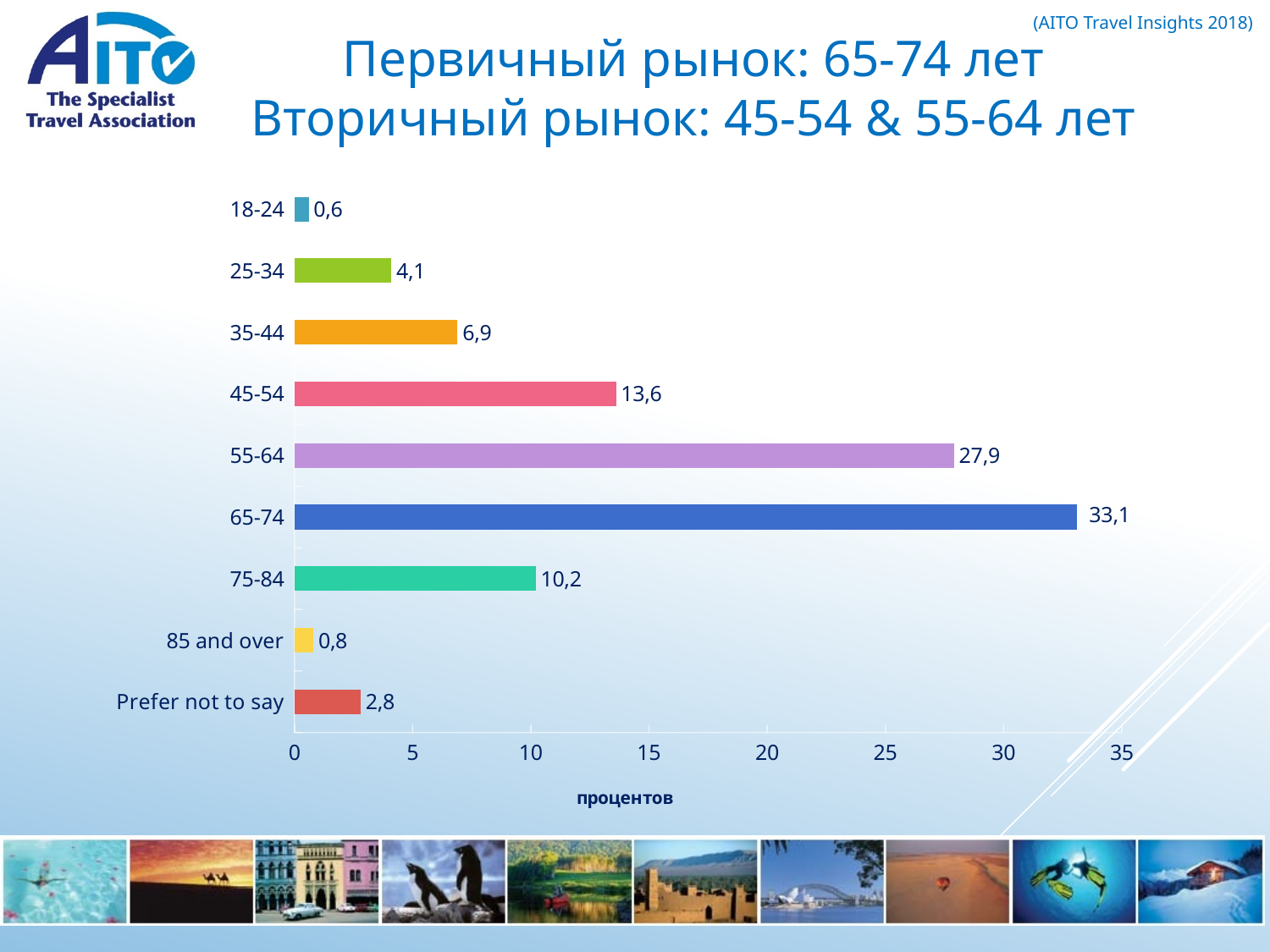
What is the value for the '85 and over' category? 0,8 Is the value for 55-64 greater or less than 25? greater Which age group has the highest value? 65-74 Which has a larger value, 35-44 or 75-84? 75-84 What is the value for the 65-74 age group? 33,1 Which category has the lowest value? 18-24 What is the label on the horizontal axis of the chart? процентов What is the difference between the values for 65-74 and 55-64? 5,2 What is the value for the 45-54 age group? 13,6 How many categories are shown in the chart? 9 What kind of chart is shown on the slide? bar chart What is the value for the 'Prefer not to say' category? 2,8